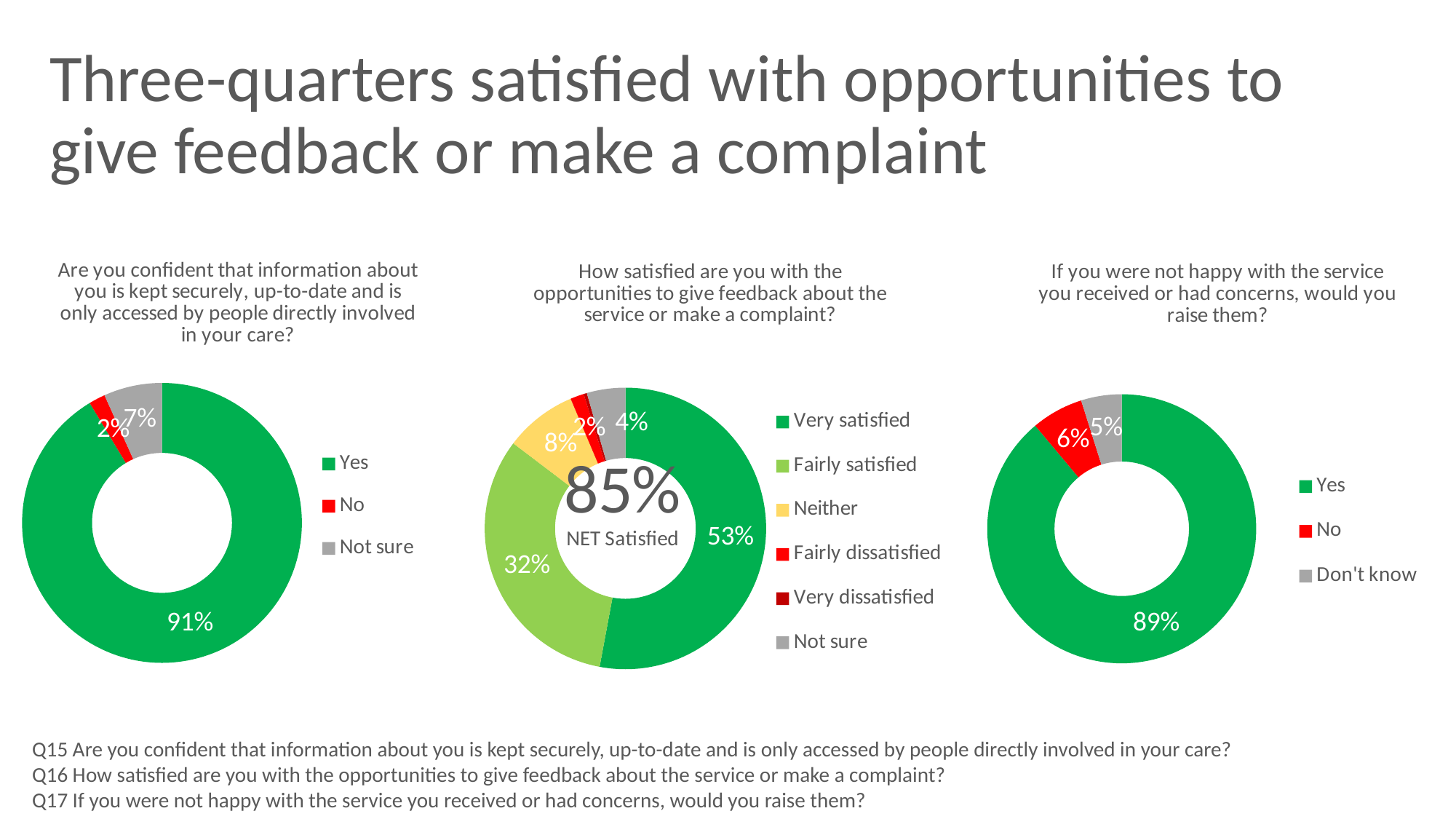
In the middle chart (How satisfied are you with the opportunities to give feedback...), what percentage were Very satisfied? 53% In the right chart (If you were not happy with the service... would you raise them?), what percentage answered No? 6% In the middle chart (How satisfied are you with the opportunities to give feedback...), what is the NET Satisfied figure shown in the centre? 85% In the right chart (If you were not happy with the service... would you raise them?), what percentage answered Yes? 89% What type of chart is used for the three charts on this slide? Donut (pie) chart In the middle chart (How satisfied are you with the opportunities to give feedback...), how many percentage points higher is Very satisfied than Fairly satisfied? 21 percentage points In the right chart (If you were not happy with the service... would you raise them?), which response has the largest share? Yes In the middle chart (How satisfied are you with the opportunities to give feedback...), what percentage were Fairly satisfied? 32% In the left chart (Are you confident that information about you is kept securely...), what percentage answered Not sure? 7% In the middle chart (How satisfied are you with the opportunities to give feedback...), how many entries does the legend list? 6 In the left chart (Are you confident that information about you is kept securely...), what percentage answered Yes? 91% In the left chart (Are you confident that information about you is kept securely...), which is larger: Yes or Not sure? Yes